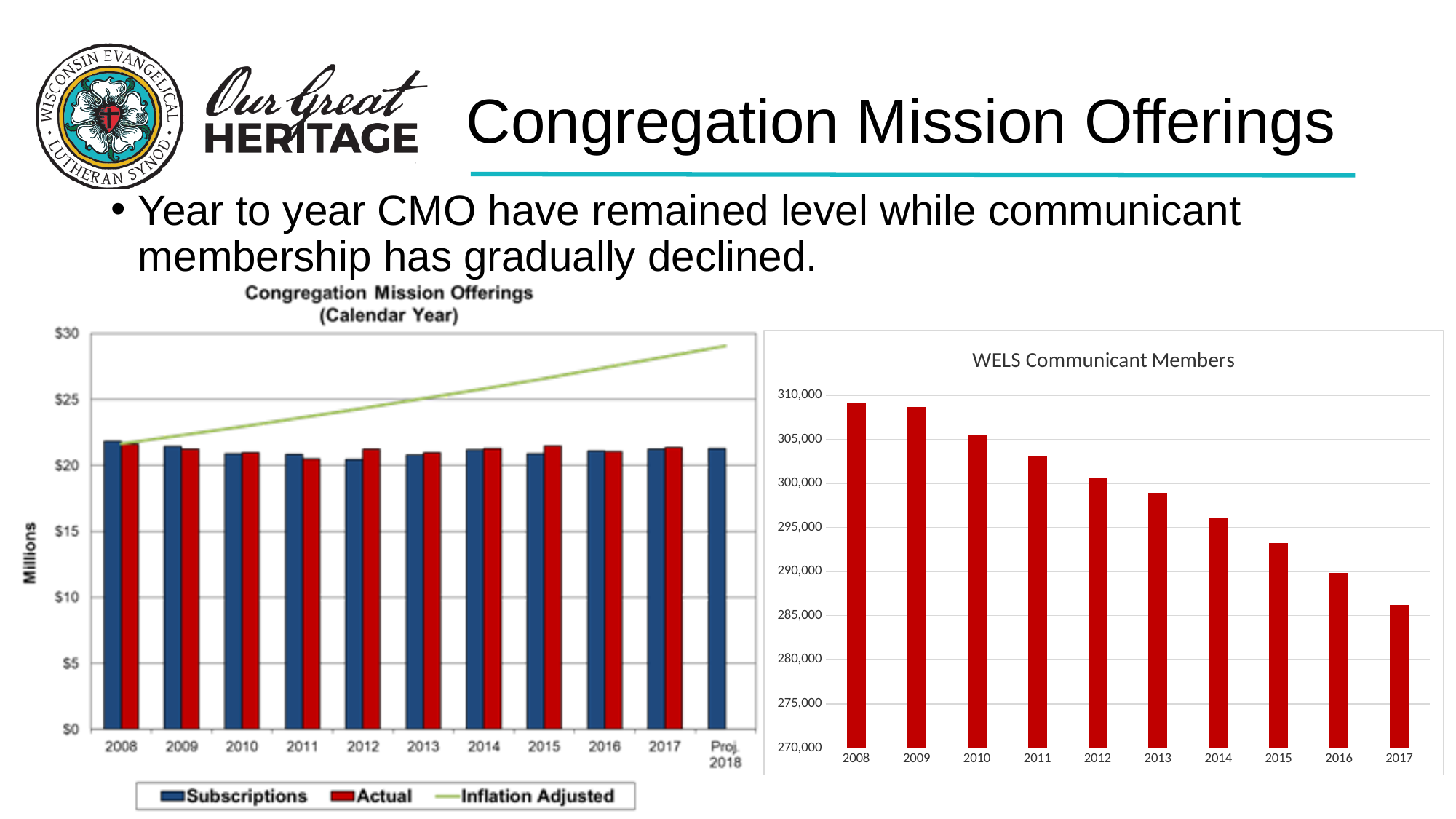
In the WELS Communicant Members chart, do the values rise or fall from 2008 to 2017? fall In the WELS Communicant Members chart, which year has the highest value? 2008 How many years are shown in the WELS Communicant Members chart? 10 In the WELS Communicant Members chart, is the value for 2015 greater or less than 295,000? less In the WELS Communicant Members chart, is the value for 2008 greater or less than 305,000? greater In the Congregation Mission Offerings (Calendar Year) chart, is the Inflation Adjusted value for Proj. 2018 greater or less than $25? greater In the WELS Communicant Members chart, which is larger, the value for 2010 or the value for 2016? 2010 What kind of chart is the WELS Communicant Members chart on the right? bar chart In the WELS Communicant Members chart, which year has the lowest value? 2017 How many series does the legend of the Congregation Mission Offerings (Calendar Year) chart list? 3 How many years (including the projected year) are shown on the x axis of the Congregation Mission Offerings (Calendar Year) chart? 11